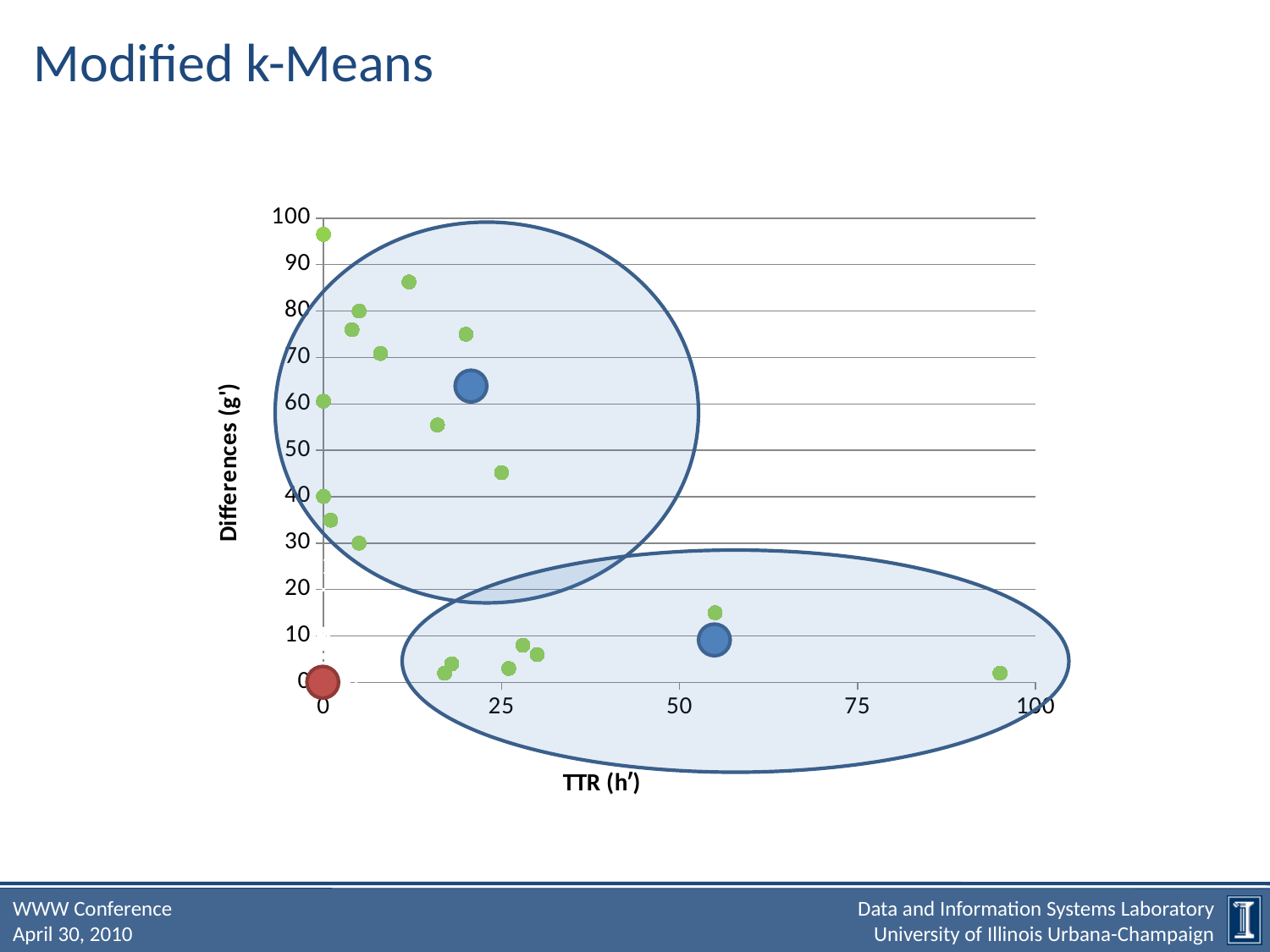
Is the Differences (g') value of the red marker greater or less than 10? less How many large blue cluster-centre markers are plotted on the chart? 2 Is the Differences (g') value of the point with the highest TTR (h') greater or less than 10? less What is the title of the x axis of the chart? TTR (h') Is the TTR (h') value of the lower large blue marker greater or less than 25? greater How many ellipses are drawn around groups of points on the chart? 2 What is the title of the y axis of the chart? Differences (g') Of the two large blue markers, does the one on the left or the one on the right have the higher Differences (g') value? the one on the left What kind of chart is shown on the slide? scatter chart